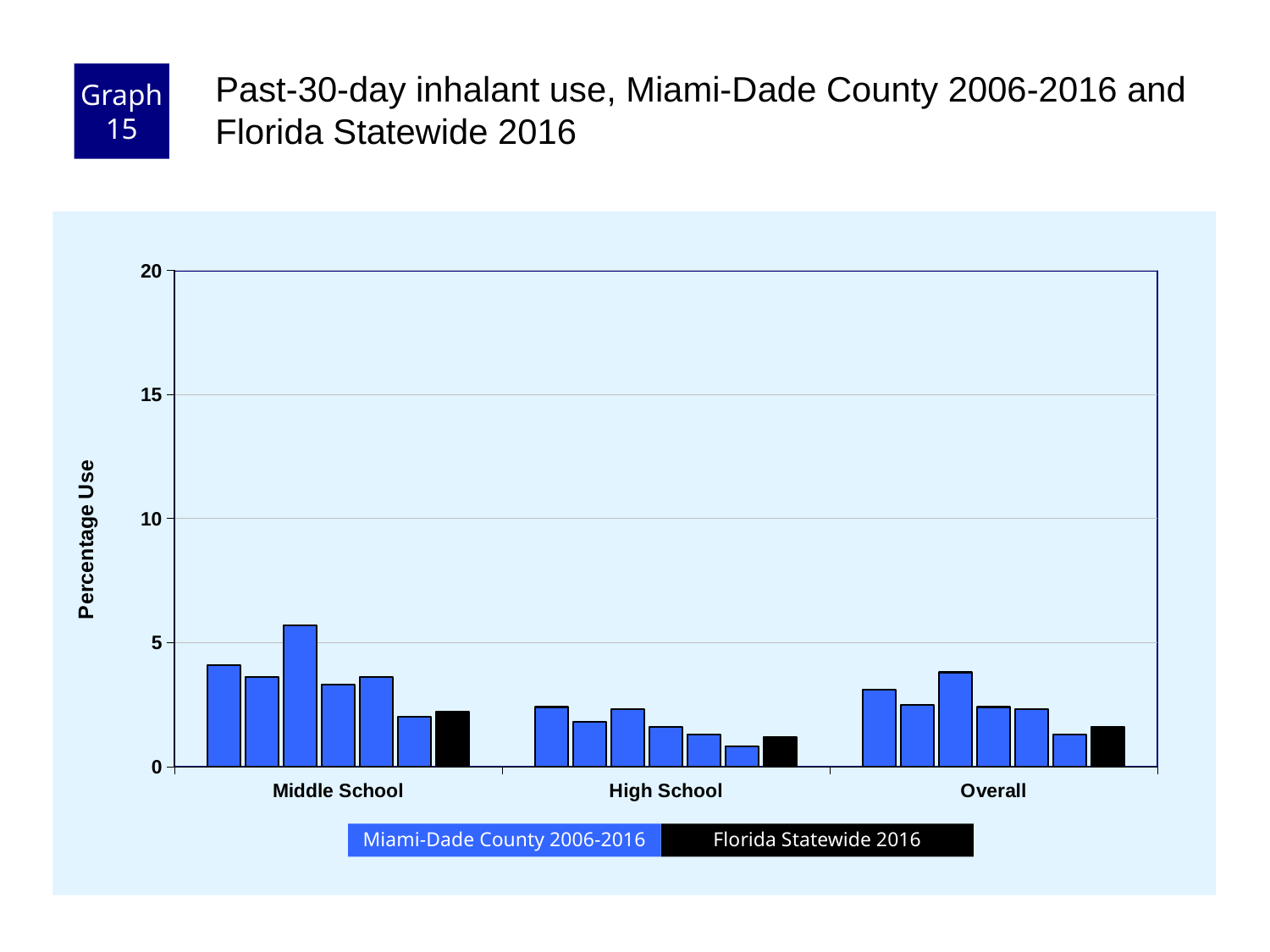
Is the tallest Miami-Dade County 2006-2016 bar in the Middle School group greater or less than 5? greater How many bars are plotted in the Middle School group? 7 What kind of chart is shown on the slide? bar chart How many categories are shown on the x axis of the chart? 3 How many series does the chart's legend list? 2 Within the High School group, do the Miami-Dade County 2006-2016 bars generally rise or fall from left to right? fall Which category group contains the tallest bar on the chart? Middle School What is the title of the chart's y axis? Percentage Use Which is larger: the Florida Statewide 2016 value for Middle School or for High School? Middle School Which category has the highest Florida Statewide 2016 bar? Middle School Is the Florida Statewide 2016 value for High School greater or less than 5? less Which category has the lowest Florida Statewide 2016 bar? High School